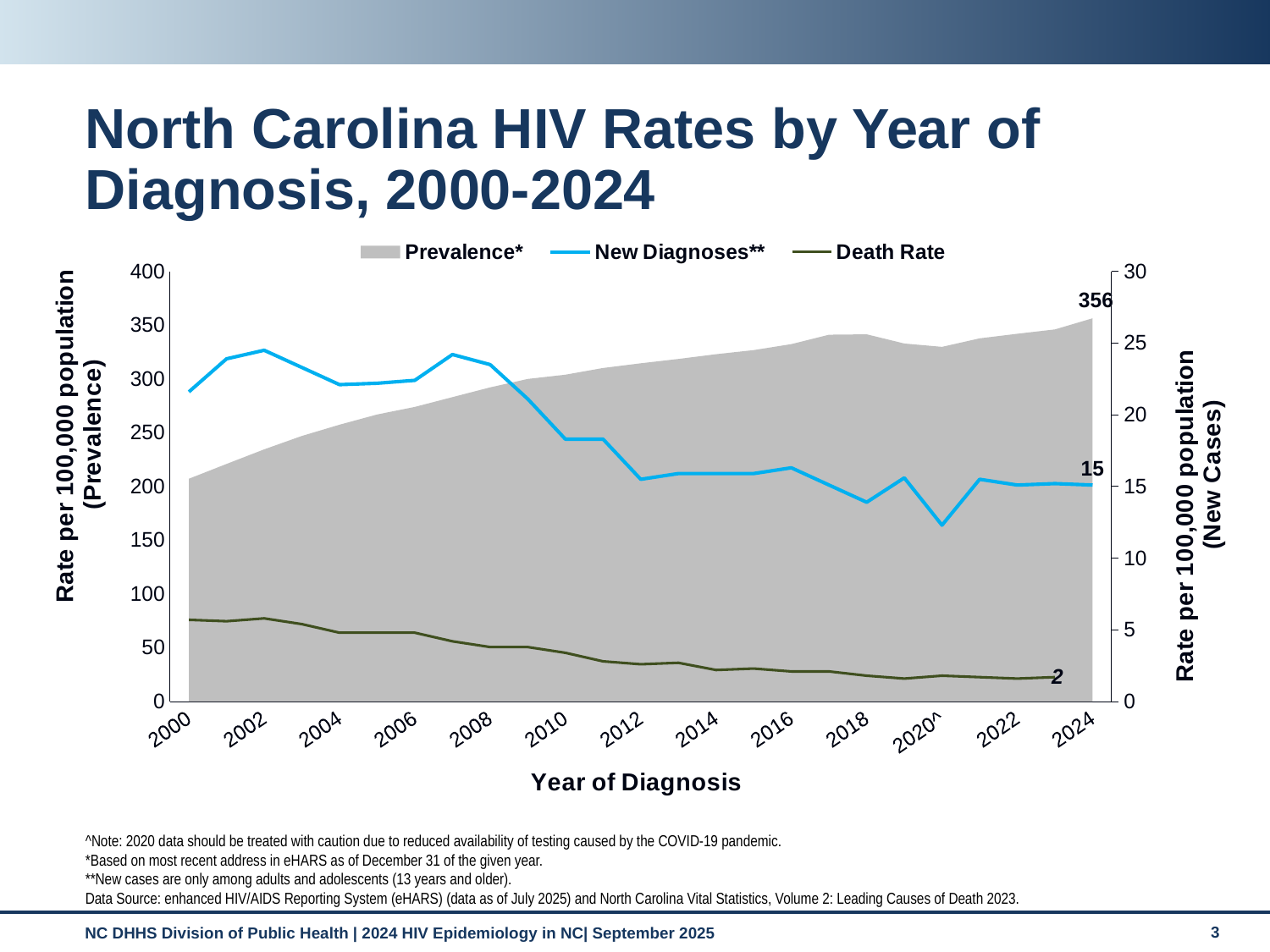
What is the labeled Prevalence value for 2024? 356 What are the three series named in the legend? Prevalence*, New Diagnoses**, Death Rate What is the last labeled value on the Death Rate line? 2 Is the New Diagnoses value for 2002 greater or less than 20 on the right axis? greater Does the Prevalence series generally rise or fall from 2000 to 2024? rise In which year is the New Diagnoses rate at its lowest? 2020^ Is the Prevalence value for 2000 greater or less than 250 on the left axis? less Which year has the higher New Diagnoses rate, 2002 or 2020^? 2002 What is the labeled New Diagnoses value for 2024? 15 Is the Death Rate value for 2000 greater or less than 10 on the right axis? less How many series does the legend list? 3 Does the Death Rate series generally rise or fall from 2000 onward? fall